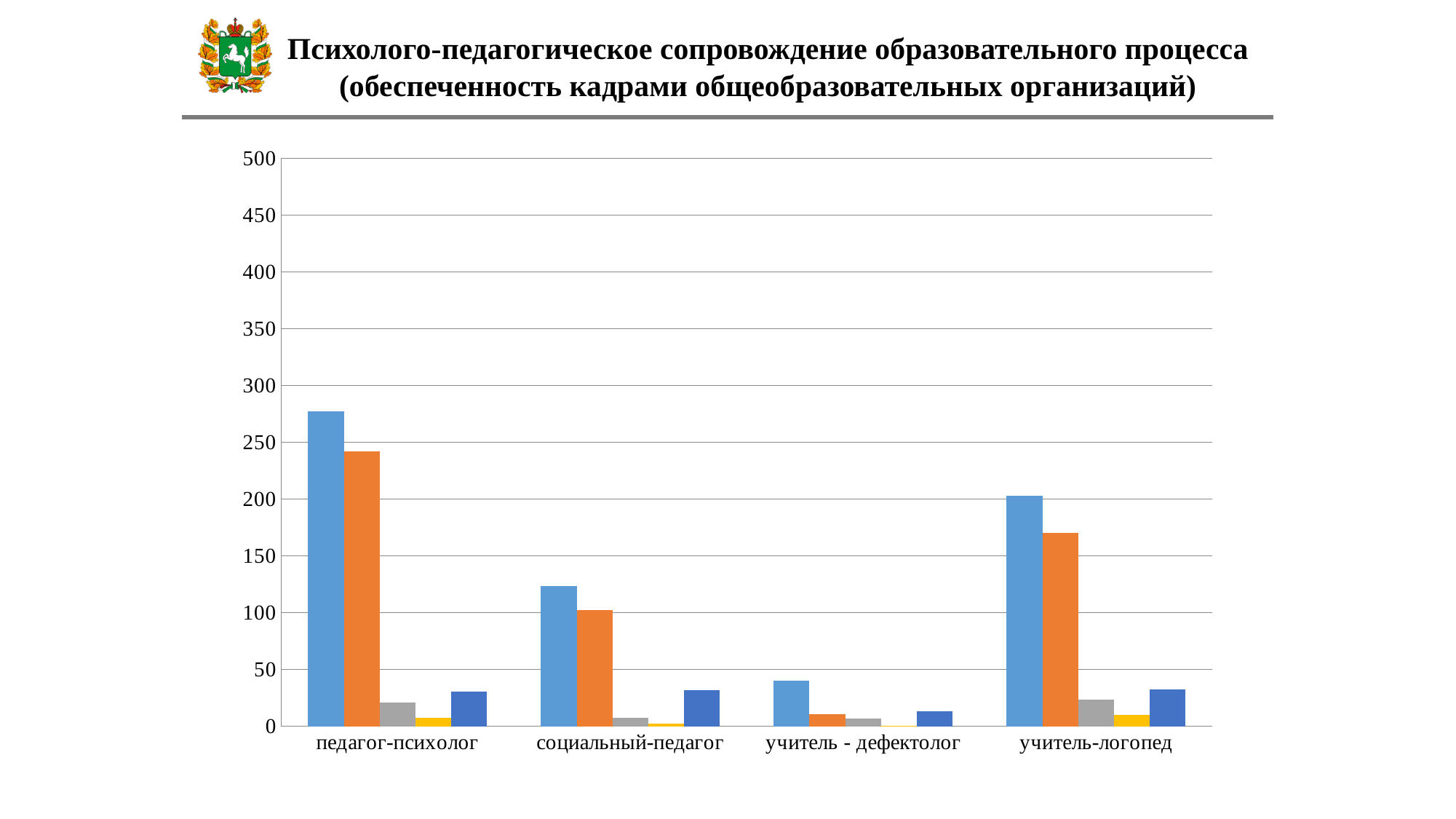
Which category has the shortest light blue bar? учитель - дефектолог What kind of chart is shown on the slide? bar chart What is the highest value shown on the vertical axis of the chart? 500 Is the orange bar for педагог-психолог greater or less than 250? less Which category has the taller orange bar, социальный-педагог or учитель-логопед? учитель-логопед How many bars are plotted for each category in the chart? 5 Is the light blue bar for социальный-педагог greater or less than 100? greater Is the light blue bar for учитель - дефектолог greater or less than 50? less Which category has the tallest light blue bar? педагог-психолог How many categories are shown on the x axis of the chart? 4